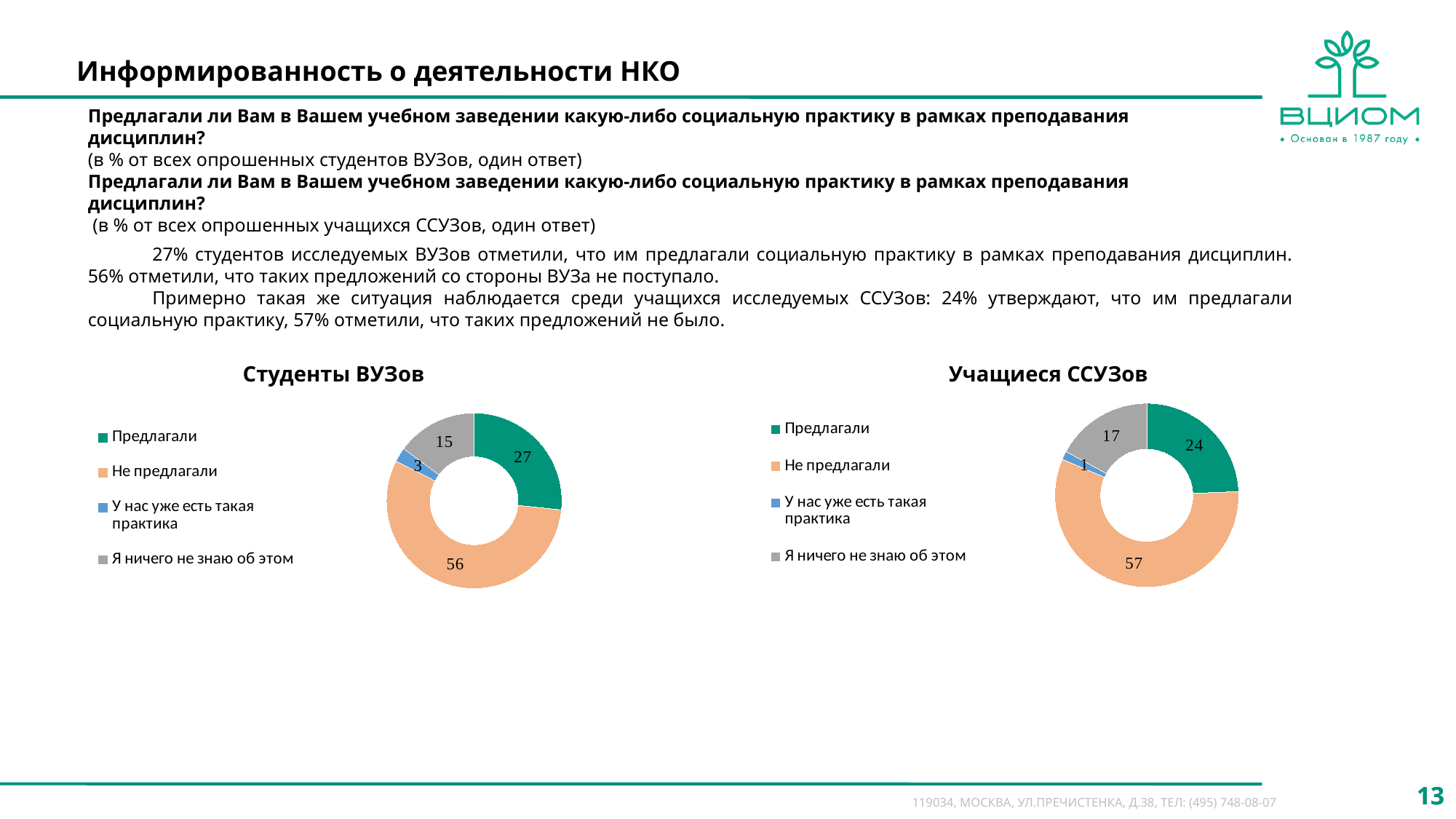
How many categories does the "Студенты ВУЗов" chart show? 4 In the "Учащиеся ССУЗов" chart, what is the value for "У нас уже есть такая практика"? 1 In the "Студенты ВУЗов" chart, what is the value for "Предлагали"? 27 In the "Студенты ВУЗов" chart, what colour is the "Не предлагали" segment? Orange In the "Студенты ВУЗов" chart, what is the difference between "Не предлагали" and "Предлагали"? 29 In the "Студенты ВУЗов" chart, what is the value for "Не предлагали"? 56 In the "Учащиеся ССУЗов" chart, what is the difference between "Предлагали" and "Я ничего не знаю об этом"? 7 Which is larger: "Предлагали" in the "Студенты ВУЗов" chart or "Предлагали" in the "Учащиеся ССУЗов" chart? Студенты ВУЗов In the "Учащиеся ССУЗов" chart, what is the value for "Я ничего не знаю об этом"? 17 What kind of chart is the "Учащиеся ССУЗов" chart? Doughnut chart In the "Студенты ВУЗов" chart, which category has the largest value? Не предлагали In the "Учащиеся ССУЗов" chart, which category has the smallest value? У нас уже есть такая практика